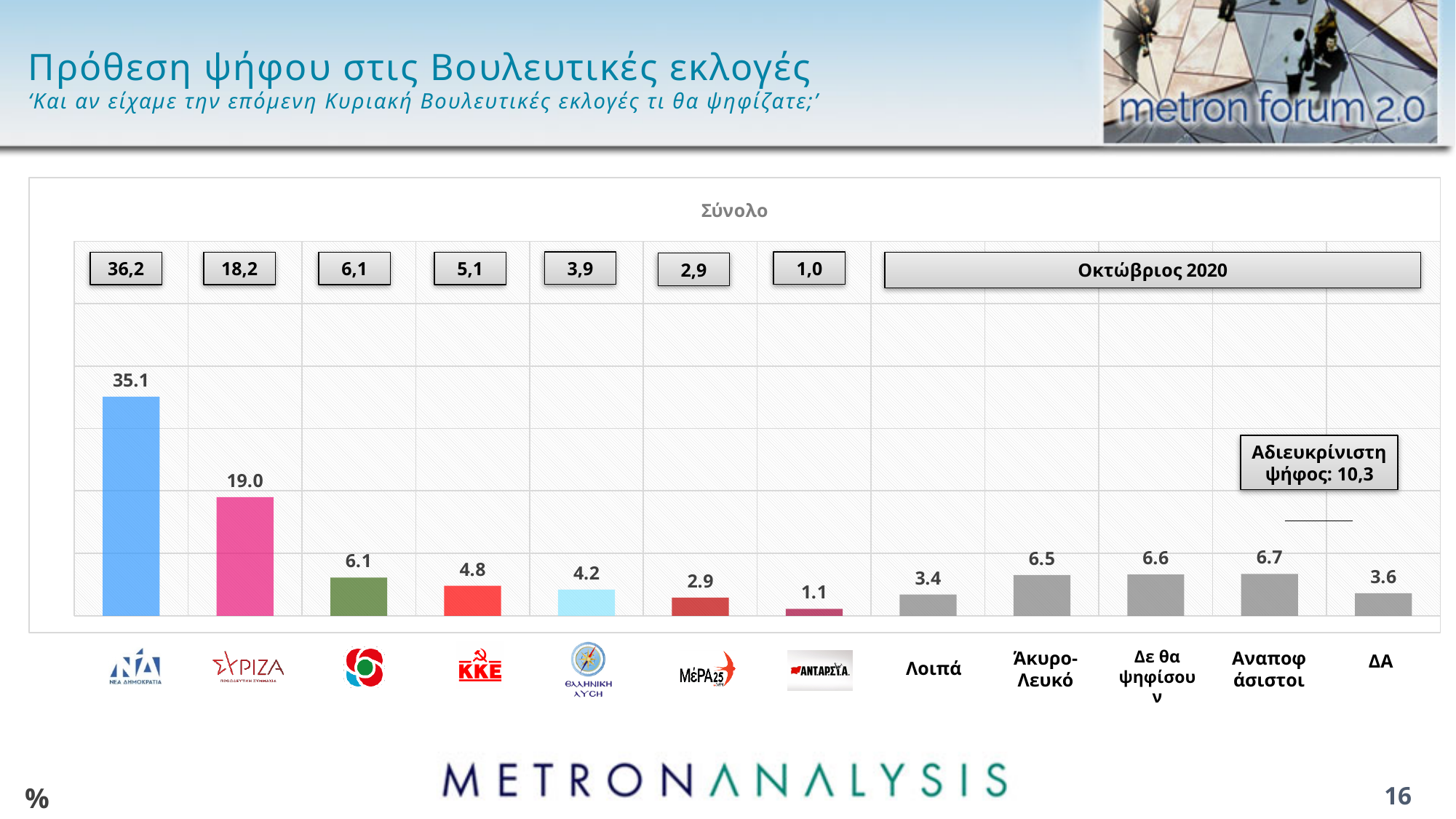
What value is given for 'Αδιευκρίνιστη ψήφος' on the slide? 10,3 What type of chart is shown on the slide? Bar chart What is the title shown above the chart area? Σύνολο What is the difference between the values for ΝΔ and ΣΥΡΙΖΑ? 16.1 What is the value shown for ΣΥΡΙΖΑ in the chart? 19.0 Which has a higher value, ΚΚΕ or Ελληνική Λύση? ΚΚΕ Which party has the highest bar in the chart? ΝΔ (Νέα Δημοκρατία) What is the value shown for 'Δε θα ψηφίσουν'? 6.6 Which category has the lowest value in the chart? ΑΝΤΑΡΣΥΑ What was the October 2020 (Οκτώβριος 2020) value shown for ΝΔ in the box above the chart? 36,2 How many bars are plotted in the chart? 12 What is the value shown for ΚΚΕ in the chart? 4.8